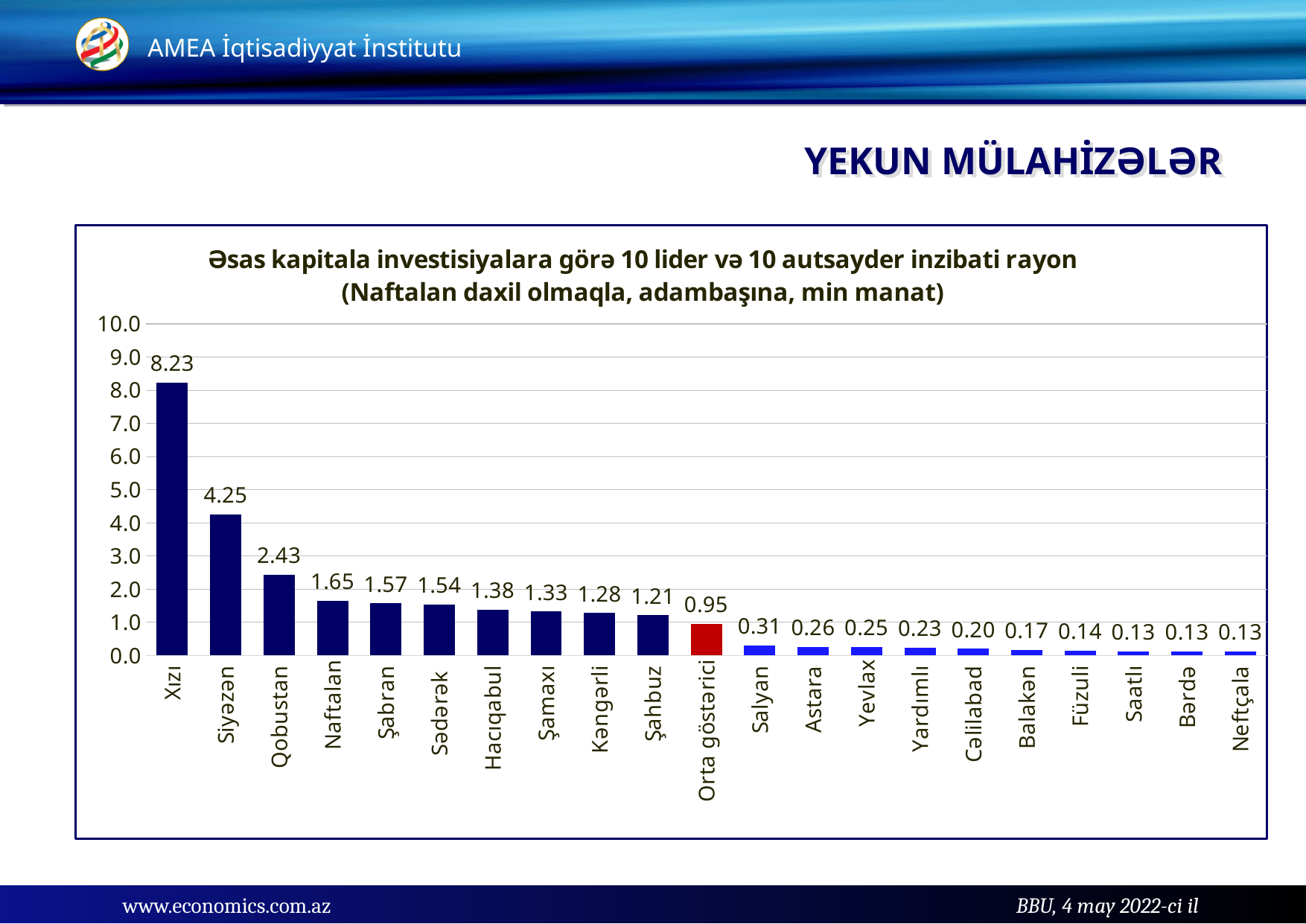
What is the value for Orta göstərici? 0.95 How many categories are shown on the x axis? 21 What is the value for Salyan? 0.31 Do the values rise or fall from left to right along the x axis? fall What kind of chart is this? bar chart Is the value for Siyəzən greater or less than 4.0? greater What is the value for Qobustan? 2.43 Which bar is coloured red? Orta göstərici Which is larger, the value for Naftalan or the value for Şabran? Naftalan What is the value for Xızı? 8.23 Which category has the highest value? Xızı What is the difference between the values for Xızı and Siyəzən? 3.98